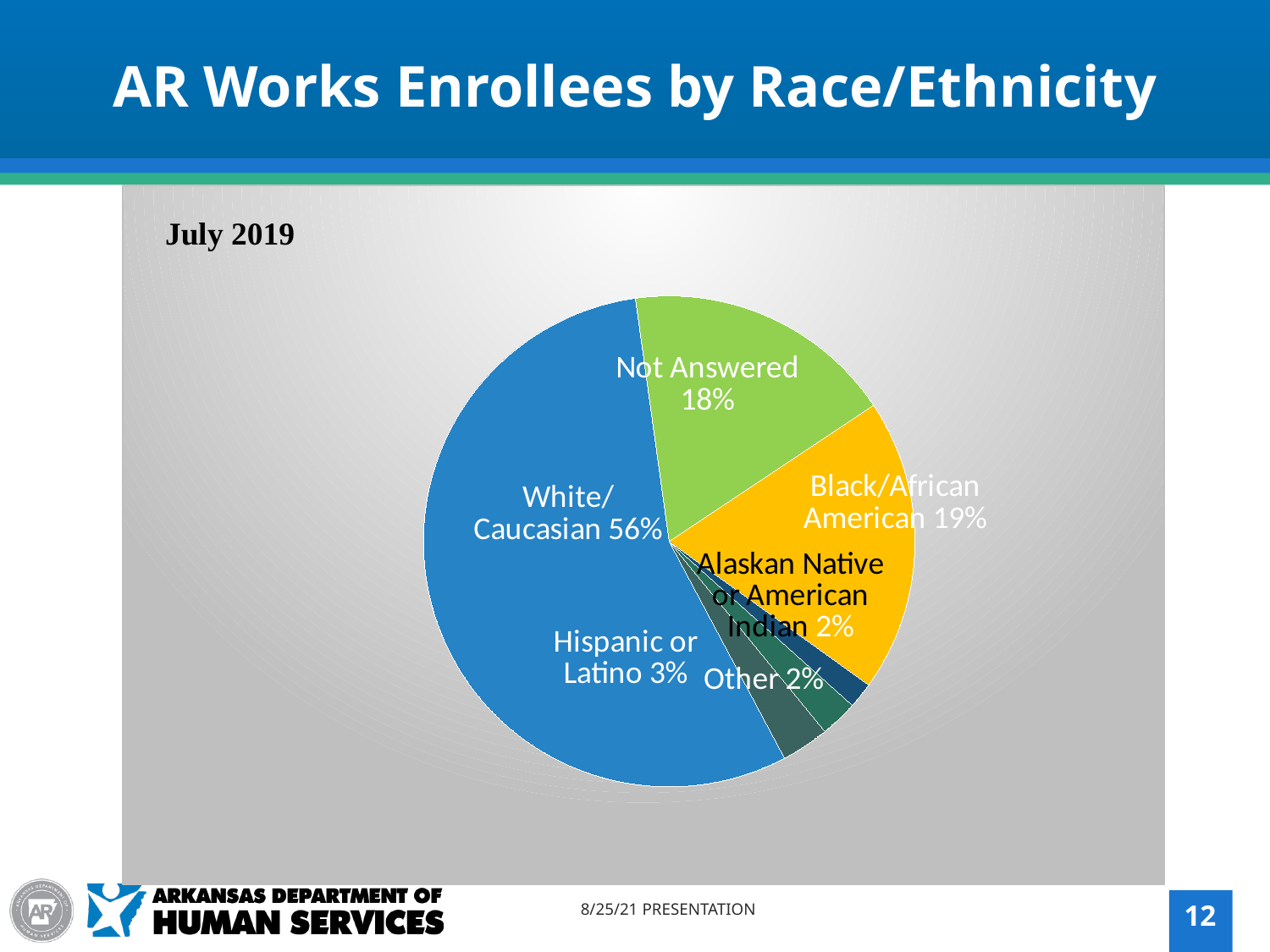
Which is larger, the Black/African American share or the Not Answered share? Black/African American What percentage of enrollees are Black/African American? 19% Which month and year does the pie chart represent? July 2019 What share of enrollees is labeled Not Answered? 18% What percentage of enrollees are Hispanic or Latino? 3% What percentage of enrollees are Alaskan Native or American Indian? 2% Which race/ethnicity category has the largest share of enrollees? White/Caucasian How many percentage points larger is the White/Caucasian share than the Black/African American share? 37 What kind of chart is shown on the slide? pie chart What is the combined share of the White/Caucasian, Black/African American and Not Answered slices? 93% How many race/ethnicity categories are labeled in the pie chart? 6 What percentage of AR Works enrollees are White/Caucasian? 56%